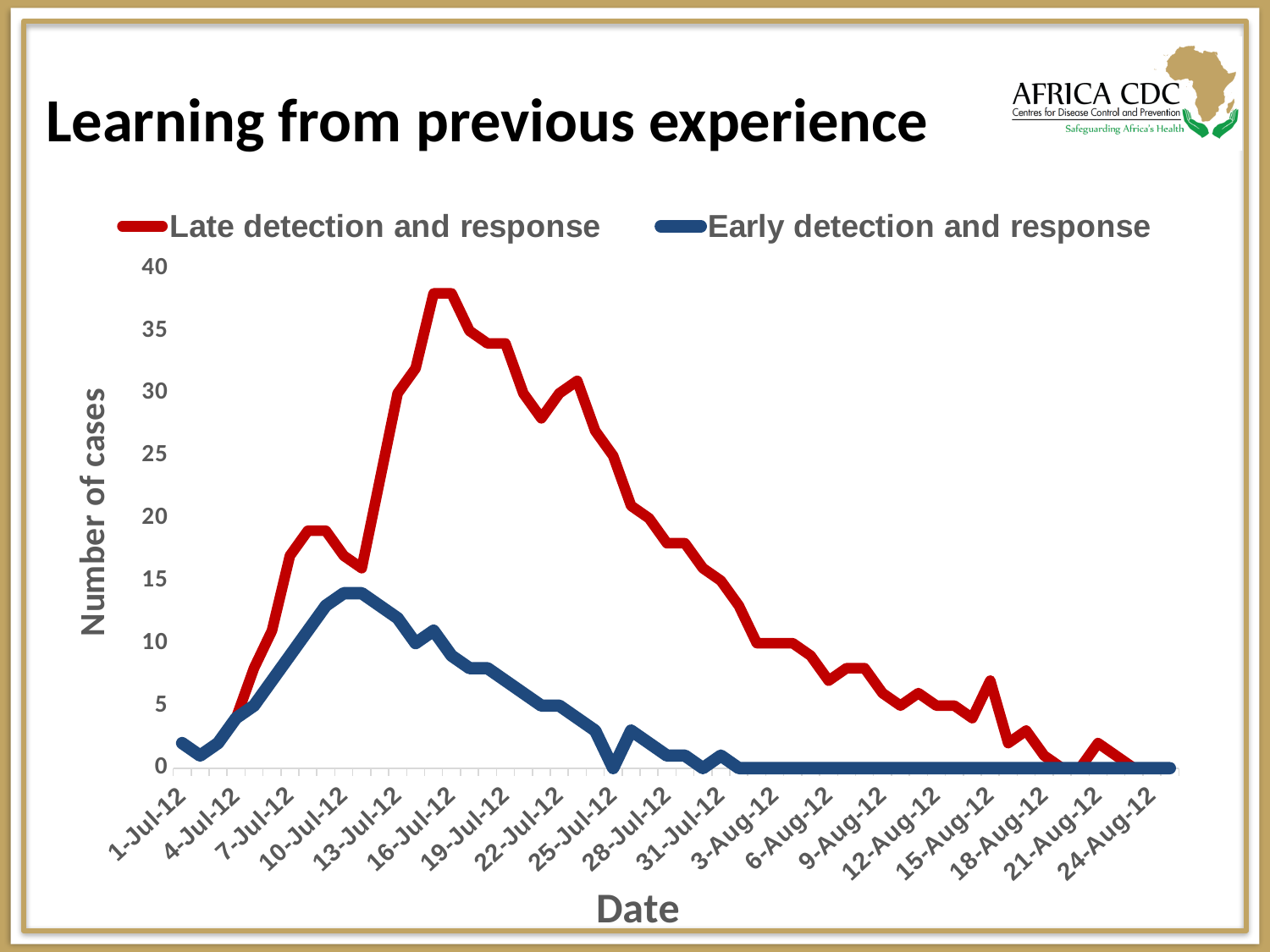
Is the value of the Late detection and response series at 1-Jul-12 greater or less than 5? less How many series does the legend list? 2 What kind of chart is shown on the slide? Line chart At 16-Jul-12, which series has the higher value? Late detection and response What is the title of the vertical axis? Number of cases Is the peak value of the Late detection and response series greater or less than 35? greater Is the peak value of the Early detection and response series greater or less than 15? less Does the Late detection and response series rise or fall between 16-Jul-12 and 24-Aug-12? fall Which series is drawn in red? Late detection and response Does the Early detection and response series rise or fall between 4-Jul-12 and 10-Jul-12? rise Which series reaches the higher peak, Late detection and response or Early detection and response? Late detection and response